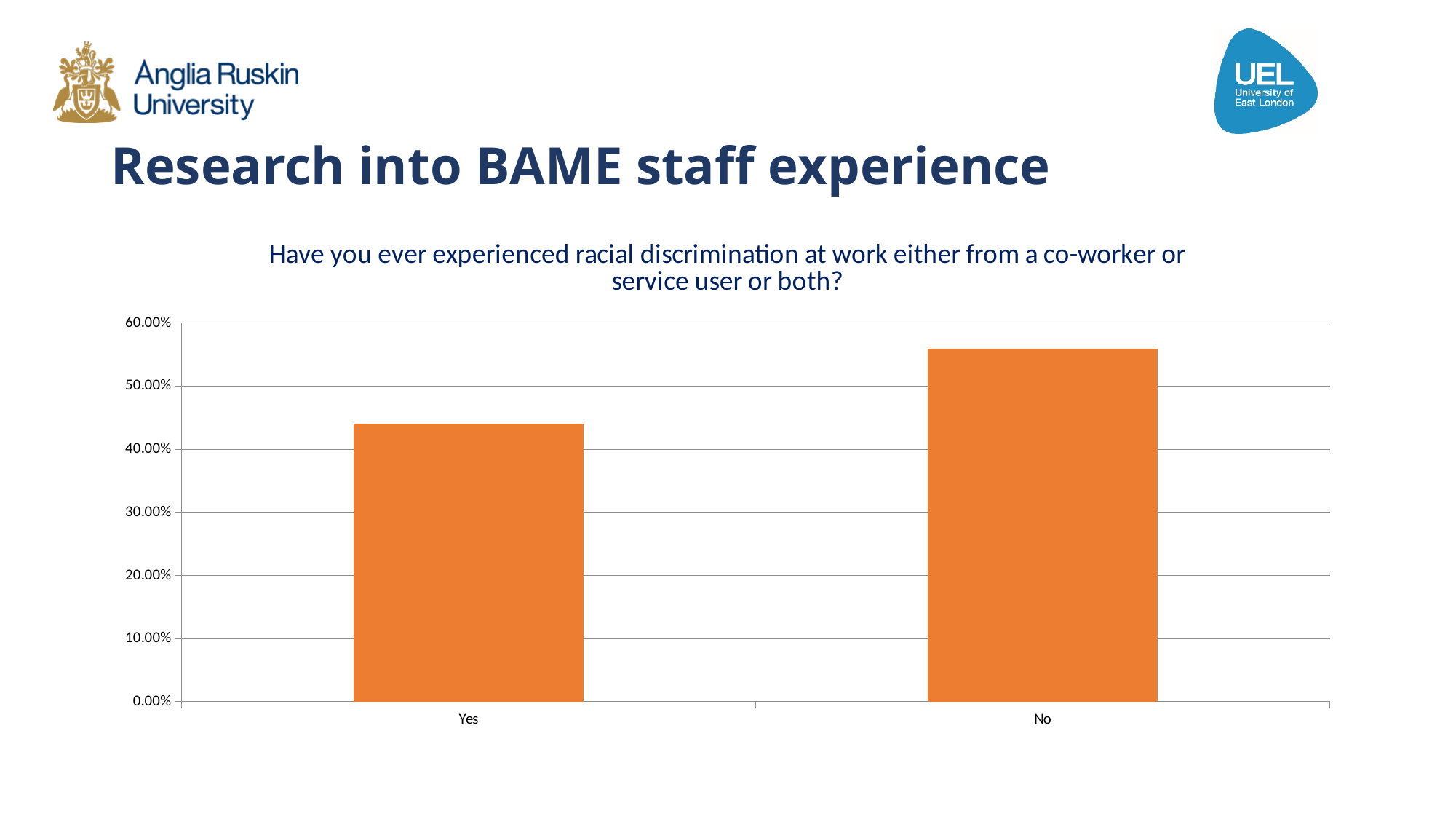
Is the value for No greater or less than 50.00%? greater Which is larger, the value for Yes or the value for No? No What is the highest value shown on the y axis? 60.00% Is the value for Yes greater or less than 40.00%? greater What kind of chart is shown on the slide? bar chart Is the value for Yes greater or less than 50.00%? less Which category has the lowest value? Yes How many categories are shown on the x axis? 2 What is the title of the chart? Have you ever experienced racial discrimination at work either from a co-worker or service user or both? Which category has the highest value? No